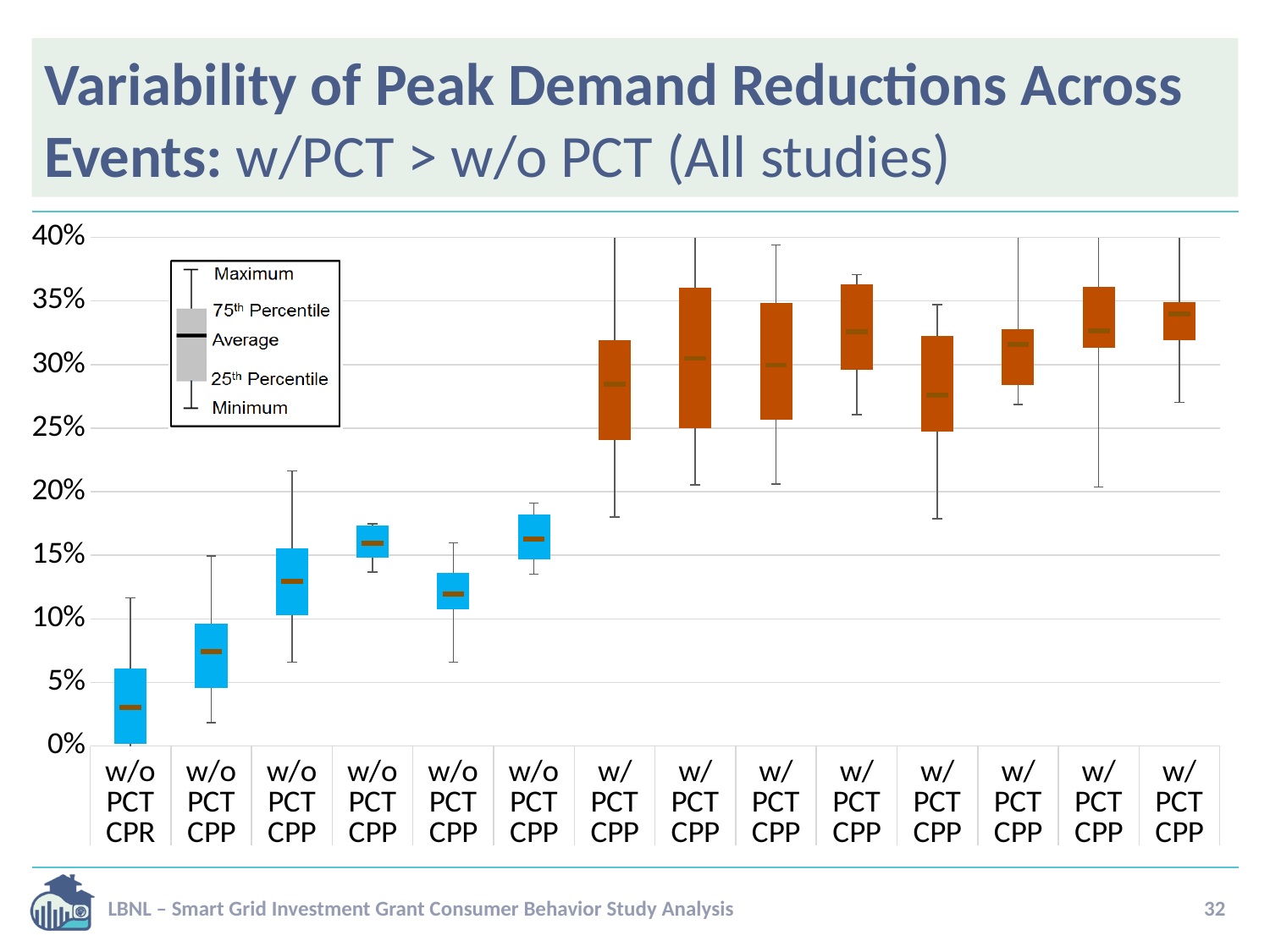
Which category has the lowest average peak demand reduction? w/o PCT CPR (the first box from the left) What colour are the boxes for the w/ PCT categories? orange How many categories (boxes) are plotted along the x axis? 14 Which has the larger average: the sixth box from the left (last w/o PCT CPP) or the seventh box from the left (first w/ PCT CPP)? the seventh box (first w/ PCT CPP) Is the average value for the last box on the right (w/ PCT CPP) greater or less than 30%? greater Is the average value for the first box from the left (w/o PCT CPR) greater or less than 5%? less How many of the plotted categories are labelled "w/o PCT"? 6 Do the average values generally rise or fall moving from the w/o PCT boxes on the left to the w/ PCT boxes on the right? rise How many of the plotted categories are labelled "w/ PCT"? 8 Is the average value for the seventh box from the left (the first w/ PCT CPP box) greater or less than 25%? greater What kind of chart is shown on the slide? box plot How many entries does the legend list? 5